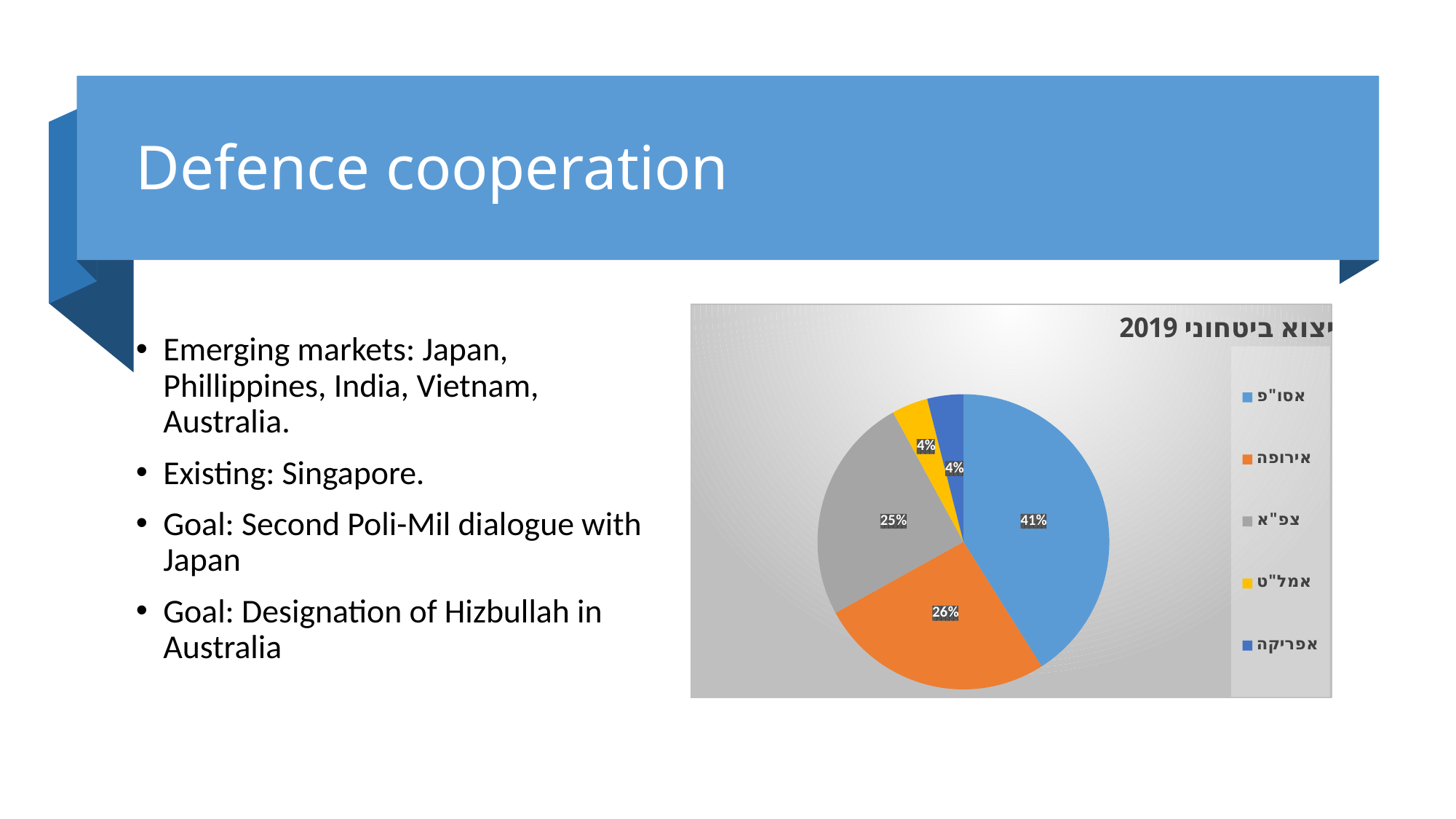
What share of the pie does אמל"ט have? 4% What colour is the slice for אירופה? orange How many entries does the chart legend list? 5 What share of the pie does אירופה have? 26% What share of the pie does צפ"א have? 25% Which is larger, the share of אירופה or the share of אמל"ט? אירופה What is the title of the chart? יצוא ביטחוני 2019 What is the difference between the shares of אסו"פ and אירופה? 15% How many slices does the pie chart have? 5 What kind of chart is shown on the slide? pie chart Which category has the largest slice of the pie? אסו"פ